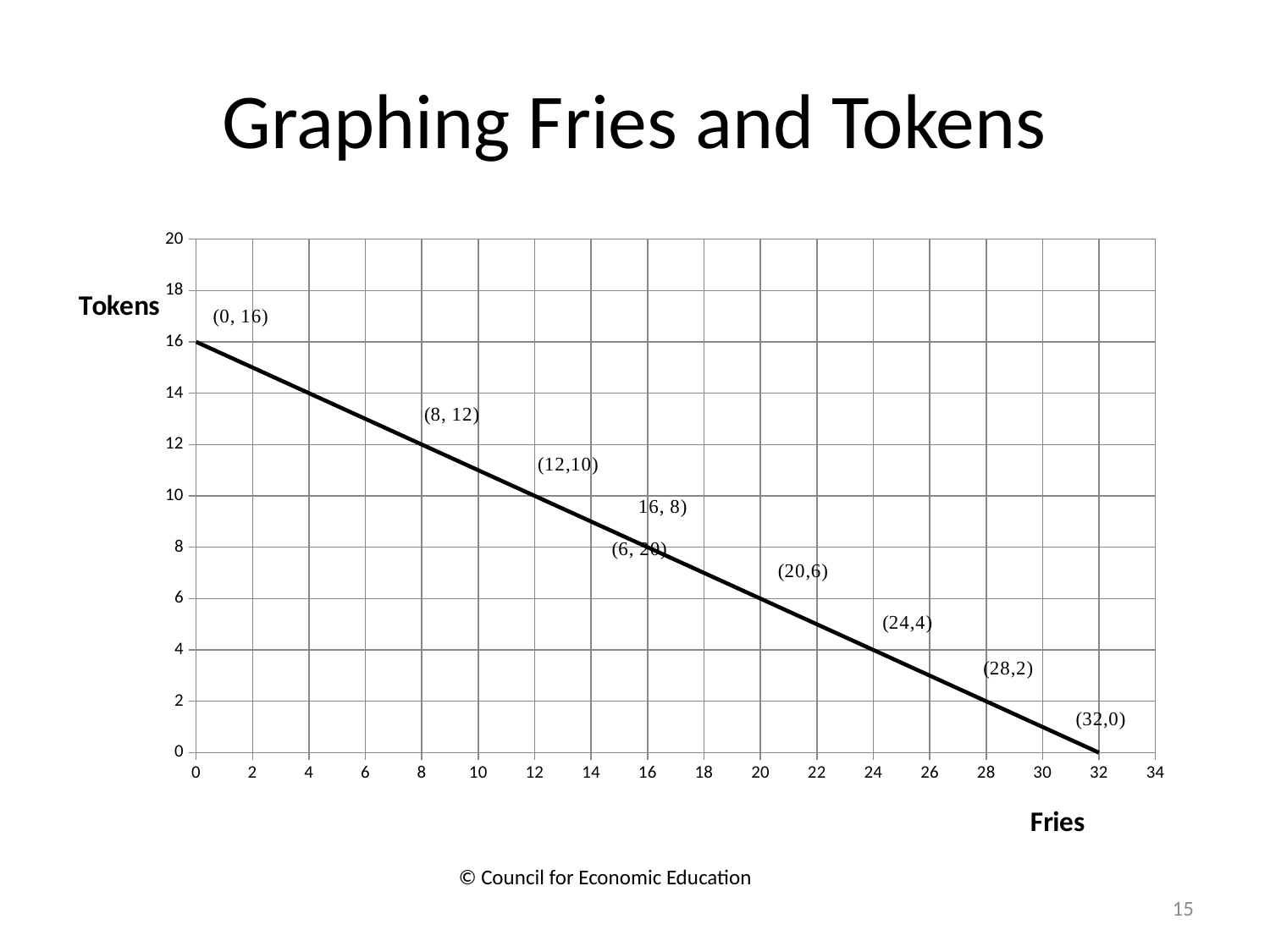
According to the labeled point, how many fries correspond to 0 tokens? 32 According to the labeled point, how many tokens correspond to 8 fries? 12 According to the labeled point, how many tokens correspond to 20 fries? 6 Which has more tokens: the point at 12 fries or the point at 24 fries? 12 fries According to the labeled point, how many tokens correspond to 0 fries? 16 What label is on the vertical axis of the chart? Tokens What is the difference in tokens between the point at 0 fries and the point at 8 fries? 4 What kind of chart is shown on the slide? line chart What is the title of the chart? Graphing Fries and Tokens Is the number of tokens at 28 fries greater or less than 4? less Do tokens rise or fall as the number of fries increases along the x axis? fall At which number of fries is the number of tokens highest? 0